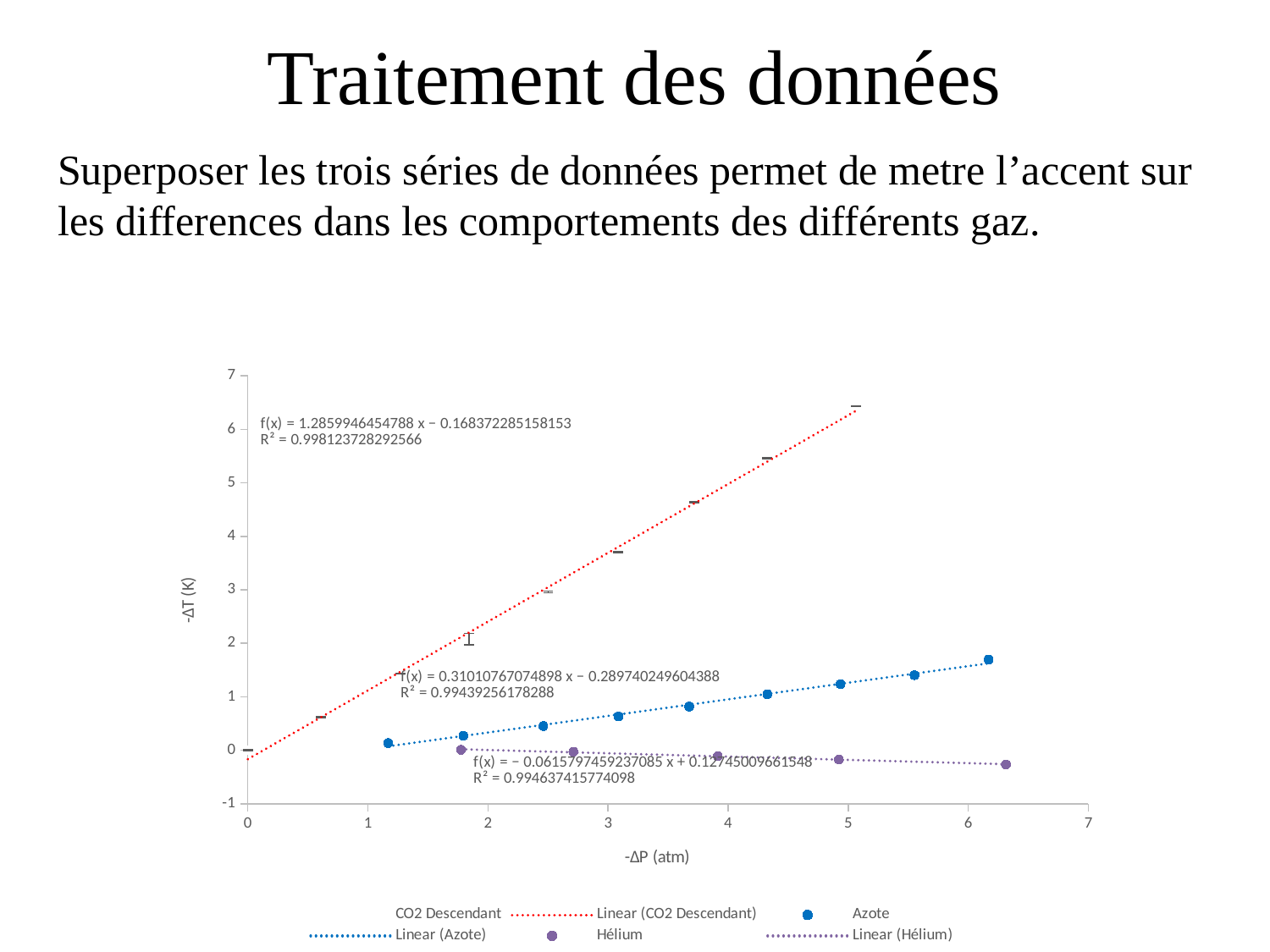
At -ΔP of about 5 atm, which series has the larger -ΔT value, CO2 Descendant or Azote? CO2 Descendant Do the CO2 Descendant values rise or fall as -ΔP increases? rise Is the -ΔT value of the highest CO2 Descendant point (near -ΔP = 5) greater or less than 6? greater Is the -ΔT value of the last Azote point (near -ΔP = 6.2) greater or less than 1? greater Which series has the lowest -ΔT values on the chart? Hélium What is the label of the x axis of the chart? -ΔP (atm) What is the label of the y axis of the chart? -ΔT (K) How many entries does the chart legend list? 6 What R² value is printed for the CO2 Descendant trendline? 0.998123728292566 Which series reaches the highest -ΔT values on the chart? CO2 Descendant What kind of chart is shown on the slide? scatter chart Do the Hélium values rise or fall as -ΔP increases? fall